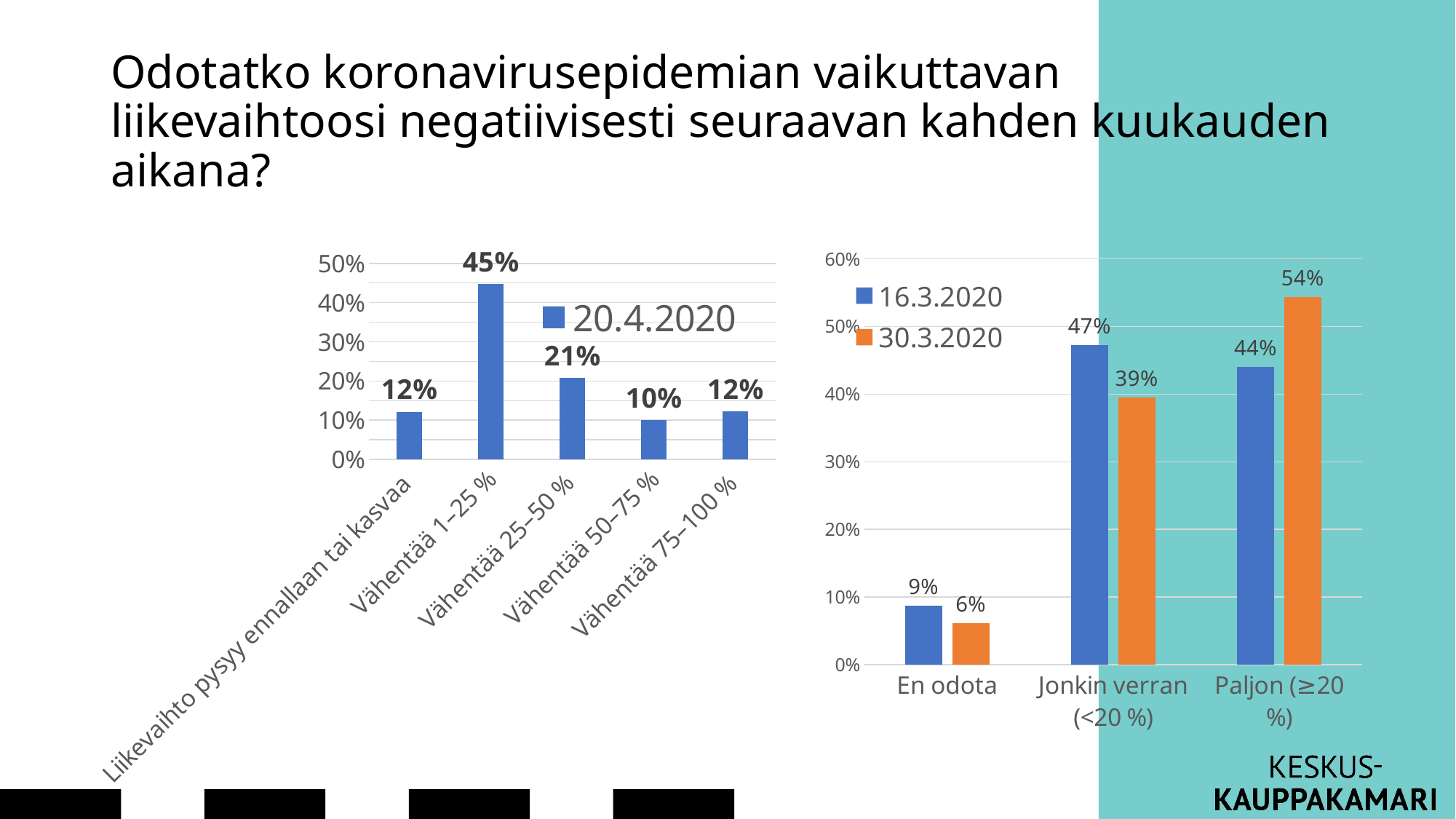
In the left chart (20.4.2020), what is the difference between 'Vähentää 1–25 %' and 'Vähentää 25–50 %'? 24 percentage points In the right chart, which is larger for 'Jonkin verran (<20 %)': 16.3.2020 or 30.3.2020? 16.3.2020 What kind of chart is the right chart? Bar chart In the left chart (20.4.2020), what is the value for 'Vähentää 75–100 %'? 12% In the right chart, which colour represents the 30.3.2020 series? Orange In the right chart, what is the difference between the 30.3.2020 and 16.3.2020 values for 'Paljon (≥20 %)'? 10 percentage points In the right chart, what is the value for 'En odota' in the 16.3.2020 series? 9% In the left chart (20.4.2020), what is the value for 'Vähentää 1–25 %'? 45% In the right chart, how many series does the legend list? 2 In the right chart, what is the value for 'Paljon (≥20 %)' in the 30.3.2020 series? 54% In the left chart (20.4.2020), how many categories are shown? 5 In the left chart (20.4.2020), which category has the lowest value? Vähentää 50–75 %